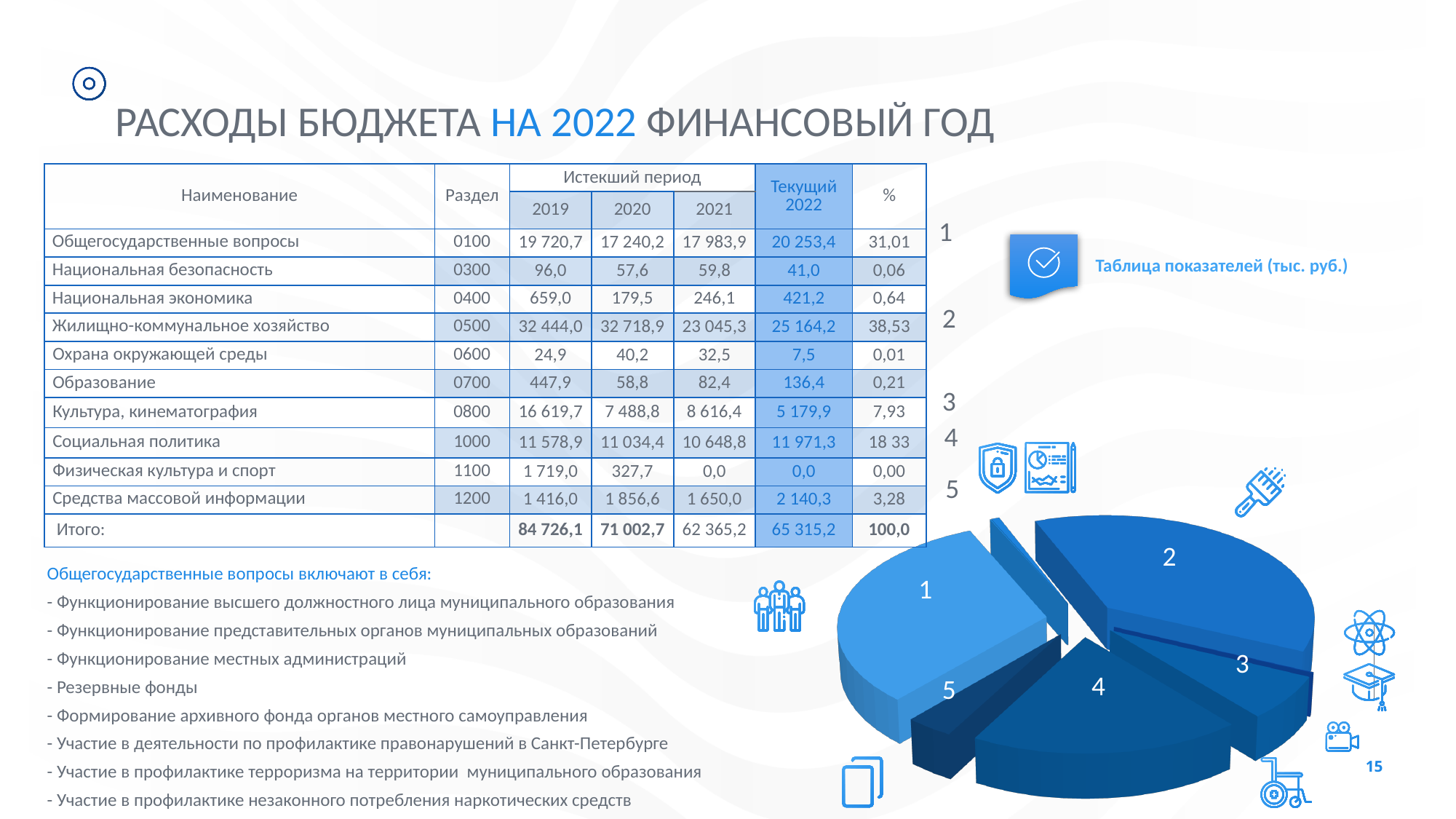
Are the slices of the pie chart pulled apart (exploded) from each other? yes What kind of chart is shown at the bottom right of the slide? pie chart Which slice of the pie chart is the smallest? 5 In the pie chart, which slice is larger, slice 1 or slice 5? 1 Which slice of the pie chart is the largest? 2 How are the slices of the pie chart labelled? with numbers 1 to 5 In the pie chart, which slice is larger, slice 2 or slice 3? 2 In the pie chart, which slice is larger, slice 4 or slice 3? 4